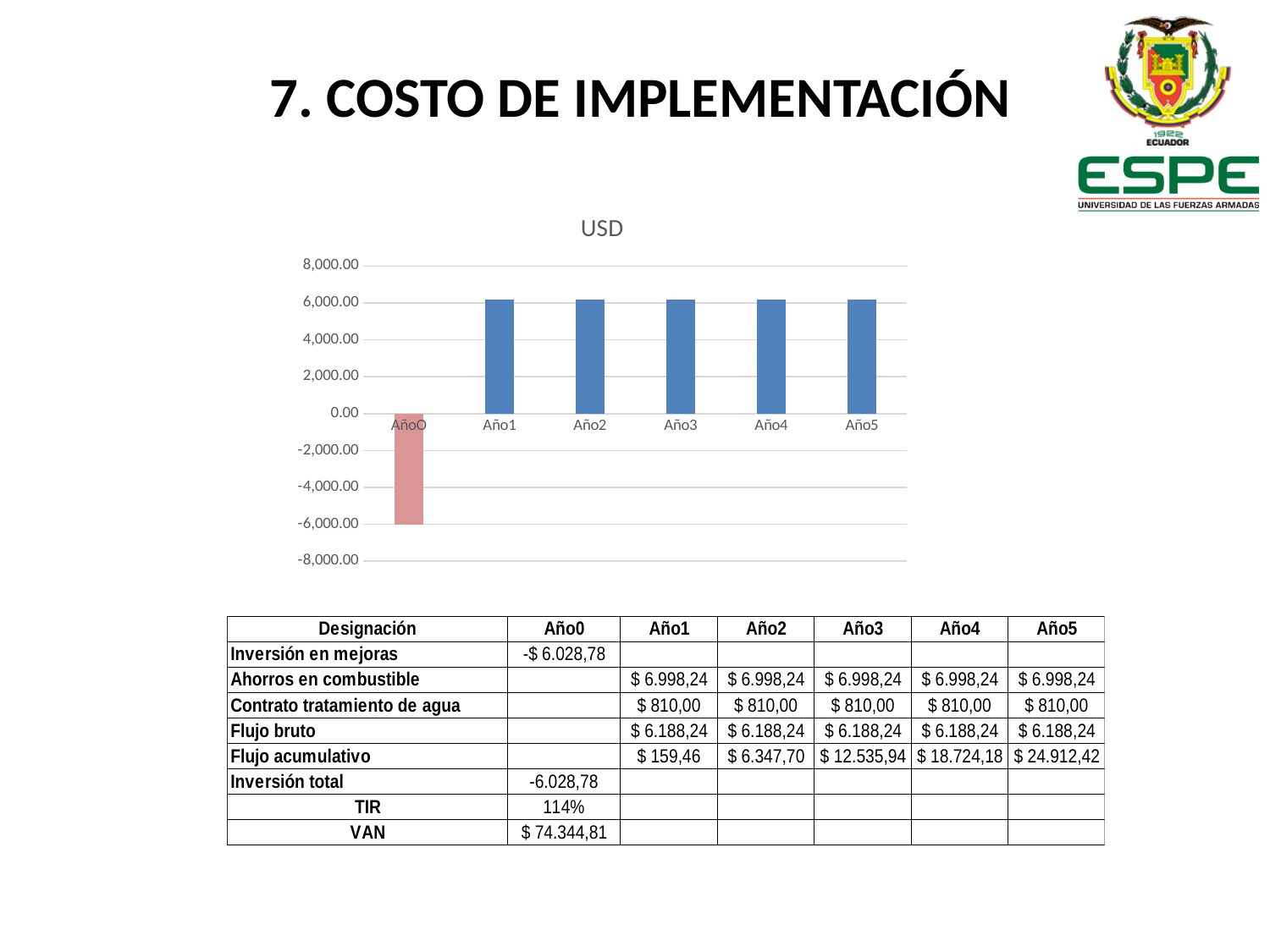
What is the title of the chart? USD Which is larger, the value for Año0 or the value for Año2? Año2 Do the values rise, fall, or stay roughly constant from Año1 to Año5? stay roughly constant Is the value for Año0 greater or less than -4,000.00? less Is the value for Año3 greater or less than 8,000.00? less Which category has the lowest value in the chart? Año0 How many bars in the chart have a negative value? 1 How many categories are plotted on the x axis of the chart? 6 What kind of chart is shown on the slide? bar chart What colour is the bar for Año0? red (pink) Is the value for Año0 greater or less than -2,000.00? less